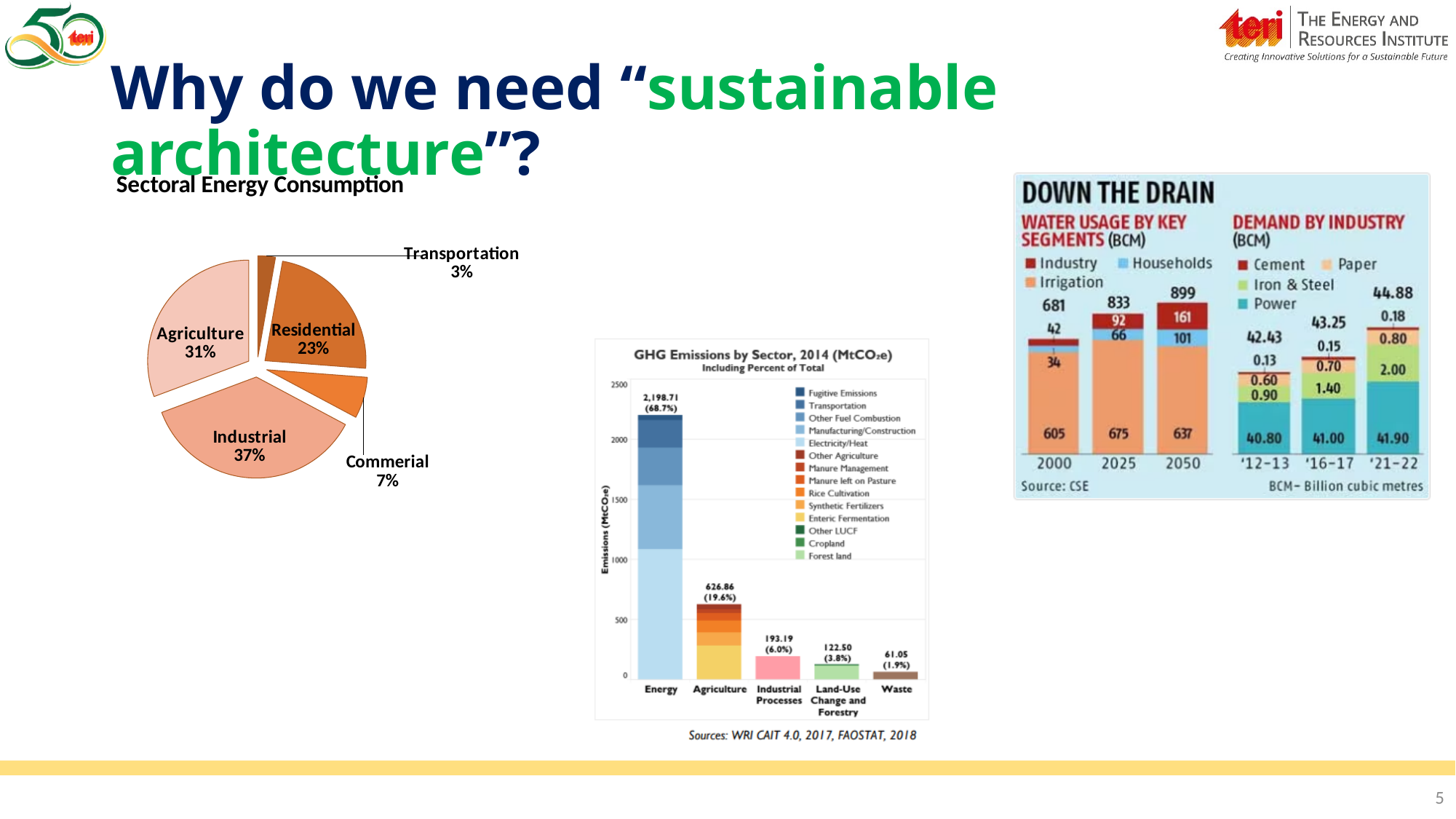
In the Down the Drain Water Usage by Key Segments chart, what is the Irrigation value for 2025? 675 What kind of chart is the Sectoral Energy Consumption chart? Pie chart In the GHG Emissions by Sector, 2014 chart, which sector has the highest emissions? Energy In the Down the Drain Demand by Industry chart, what is the Power value for '21-22? 41.90 In the GHG Emissions by Sector, 2014 chart, what percent of total does Waste account for? 1.9% In the Sectoral Energy Consumption pie chart, which sector has the smallest share? Transportation In the Sectoral Energy Consumption pie chart, what is the difference between the Agriculture and Residential shares? 8% In the Sectoral Energy Consumption pie chart, what share does Industrial have? 37% In the GHG Emissions by Sector, 2014 chart, what is the value for Agriculture? 626.86 In the GHG Emissions by Sector, 2014 chart, how many sectors are plotted on the x axis? 5 In the Sectoral Energy Consumption pie chart, how many sectors are shown? 5 In the Down the Drain Water Usage by Key Segments chart, what is the total water usage for 2050? 899